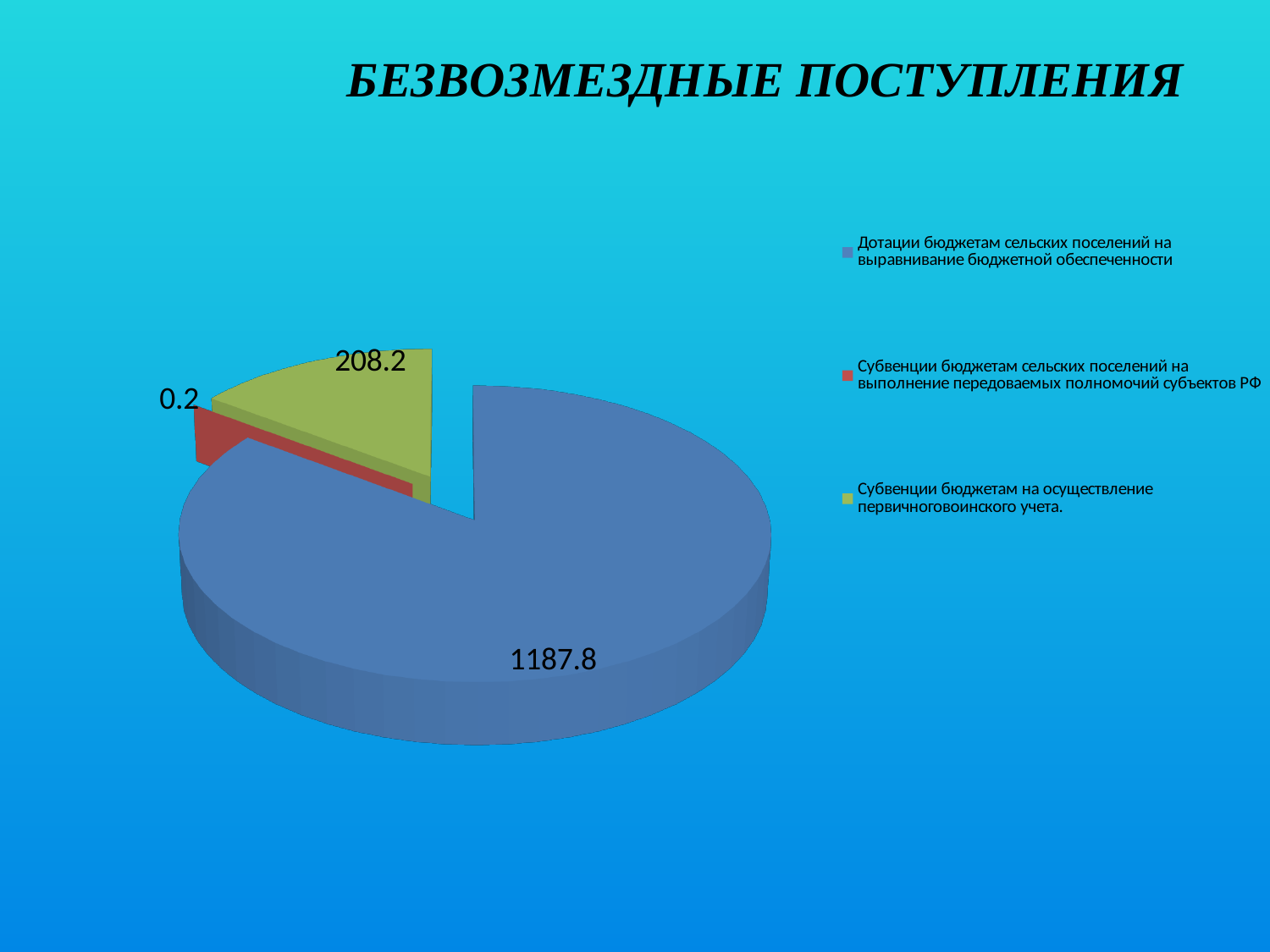
What colour is the slice for 'Субвенции бюджетам на осуществление первичноговоинского учета.'? Green What is the total of all three values shown on the pie chart? 1396.2 Which is larger: the value for 'Субвенции бюджетам на осуществление первичноговоинского учета.' or the value for 'Субвенции бюджетам сельских поселений на выполнение передоваемых полномочий субъектов РФ'? Субвенции бюджетам на осуществление первичноговоинского учета. What is the difference between the value for 'Дотации бюджетам сельских поселений на выравнивание бюджетной обеспеченности' and the value for 'Субвенции бюджетам на осуществление первичноговоинского учета.'? 979.6 Which category has the smallest slice of the pie? Субвенции бюджетам сельских поселений на выполнение передоваемых полномочий субъектов РФ What type of chart is shown on the slide? Pie chart What is the value for 'Субвенции бюджетам сельских поселений на выполнение передоваемых полномочий субъектов РФ'? 0.2 What is the value for 'Субвенции бюджетам на осуществление первичноговоинского учета.'? 208.2 How many slices does the pie chart have? 3 What is the value for 'Дотации бюджетам сельских поселений на выравнивание бюджетной обеспеченности'? 1187.8 Which category has the largest slice of the pie? Дотации бюджетам сельских поселений на выравнивание бюджетной обеспеченности What is the title of the chart? БЕЗВОЗМЕЗДНЫЕ ПОСТУПЛЕНИЯ